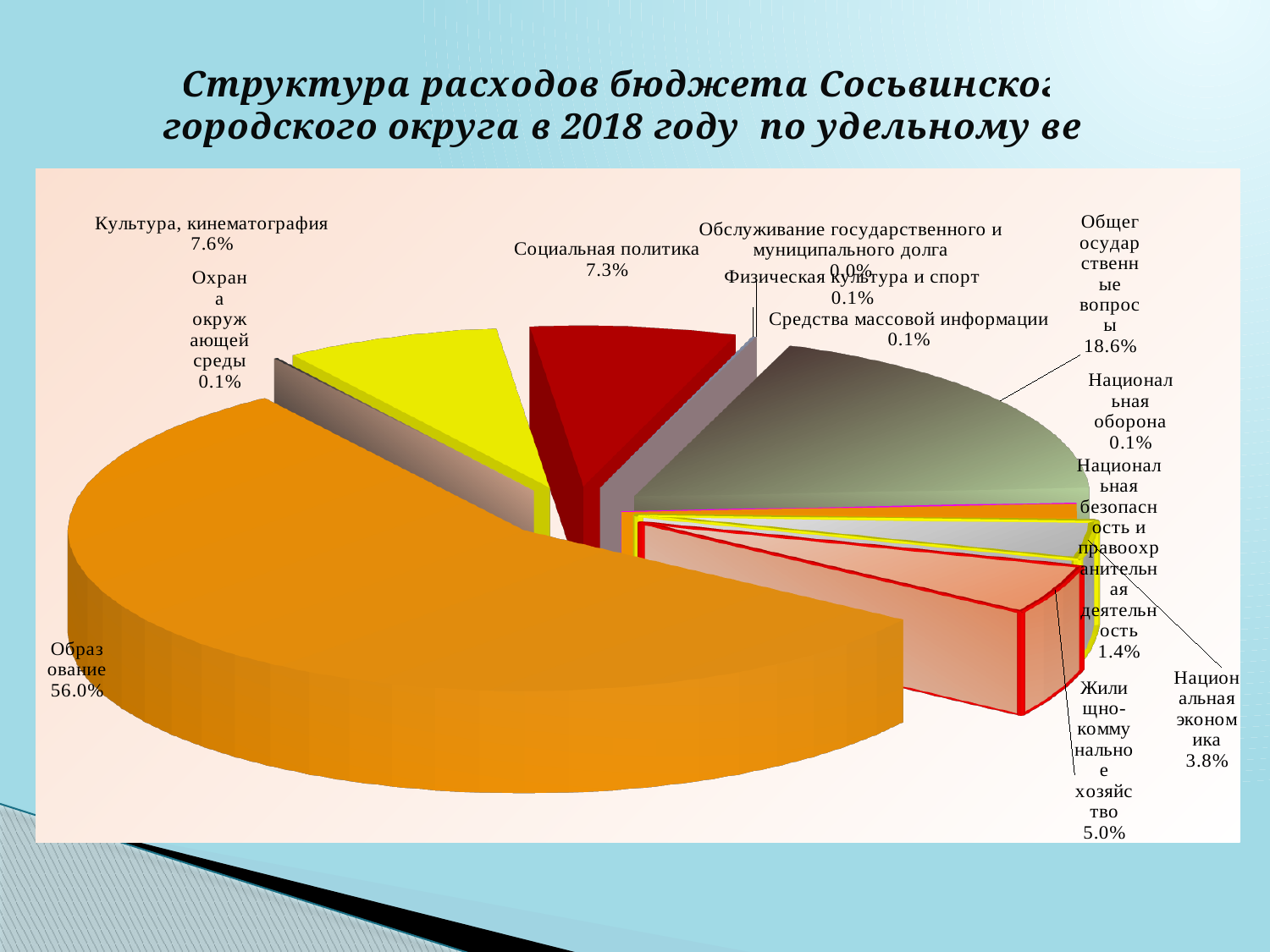
What is the value shown for Жилищно-коммунальное хозяйство? 5.0% Which category has the largest share of the pie? Образование What is the value shown for Социальная политика? 7.3% What is the value shown for Общегосударственные вопросы? 18.6% What share of the pie does Образование account for? 56.0% What kind of chart is shown on the slide? Pie chart What is the value shown for Национальная безопасность и правоохранительная деятельность? 1.4% Which is larger, the share for Культура, кинематография or the share for Социальная политика? Культура, кинематография How many categories are shown in the pie chart? 12 What is the value shown for Культура, кинематография? 7.6% What is the value shown for Национальная экономика? 3.8% What is the difference between the shares of Образование and Общегосударственные вопросы? 37.4%